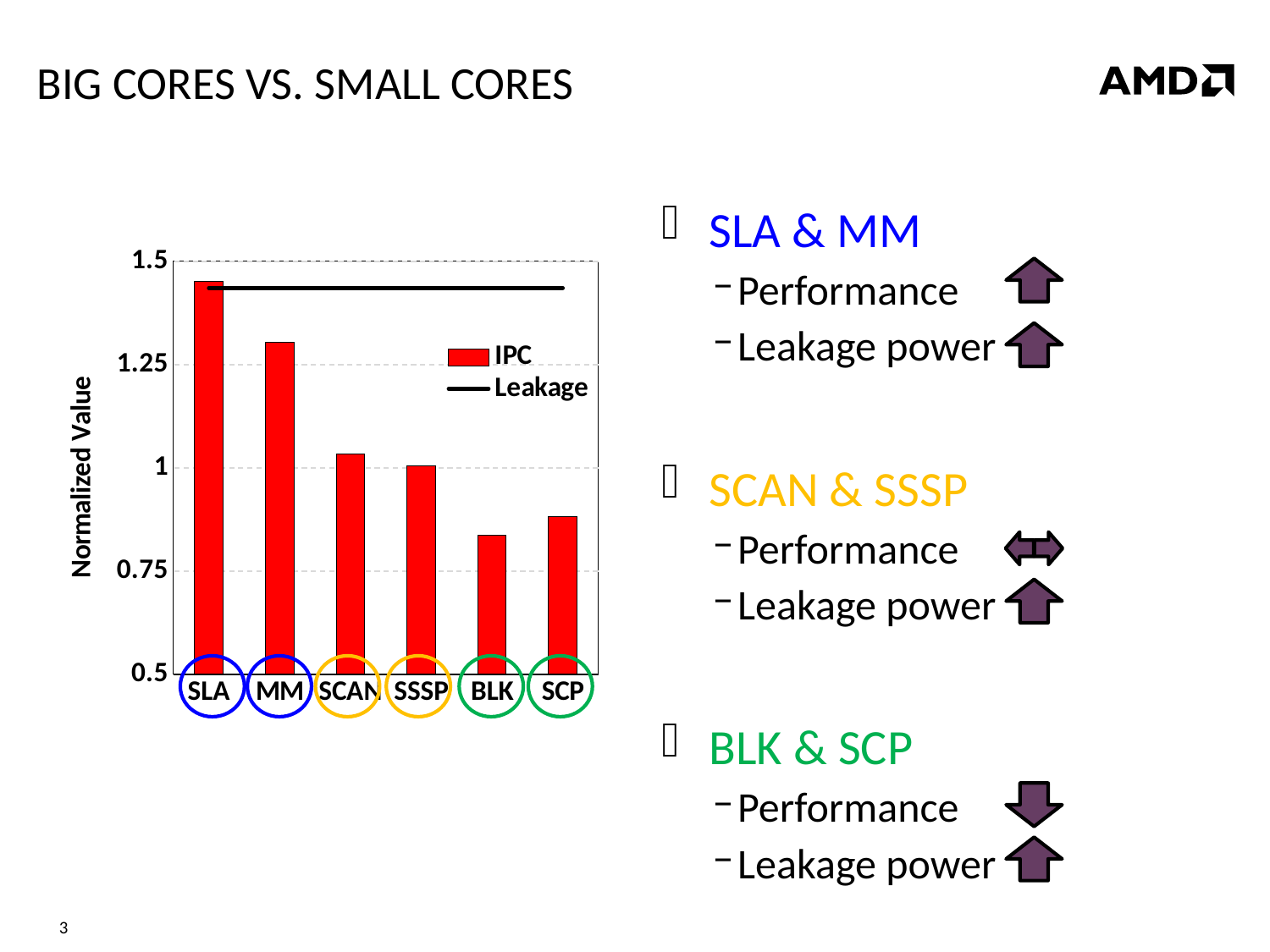
Is the IPC value for BLK greater or less than 1? less What kind of chart is shown on the slide? combination bar and line chart Which category has the highest IPC bar? SLA Which has the larger IPC value, SLA or MM? SLA Is the IPC value for MM greater or less than 1.5? less How many series does the chart legend list? 2 Is the Leakage line greater or less than 1.25? greater Do the IPC bars generally rise or fall from SLA to SCP along the x axis? fall What is the label of the chart's y axis? Normalized Value Which category has the lowest IPC bar? BLK How many categories are shown on the x axis of the chart? 6